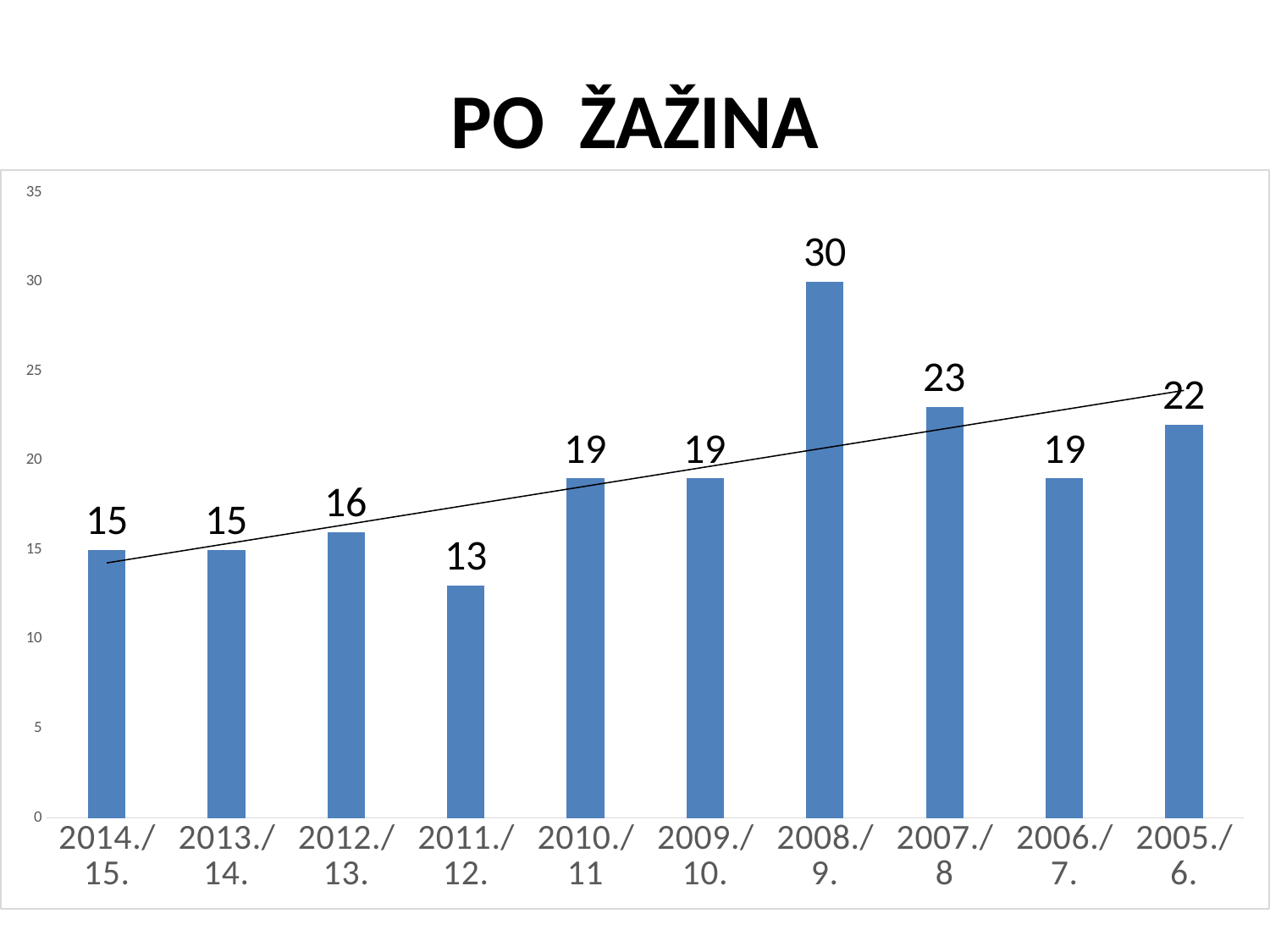
Is the value for 2007./8 greater or less than 20? greater What is the difference between the values for 2005./6. and 2014./15.? 7 How many categories are shown on the x axis? 10 Which category has the lowest value? 2011./12. Which category has the highest value? 2008./9. What is the value for 2008./9.? 30 What is the difference between the values for 2008./9. and 2007./8? 7 What kind of chart is this? bar chart What is the title of the chart? PO ŽAŽINA Which is larger, the value for 2012./13. or the value for 2006./7.? 2006./7. What is the value for 2011./12.? 13 What is the value for 2005./6.? 22